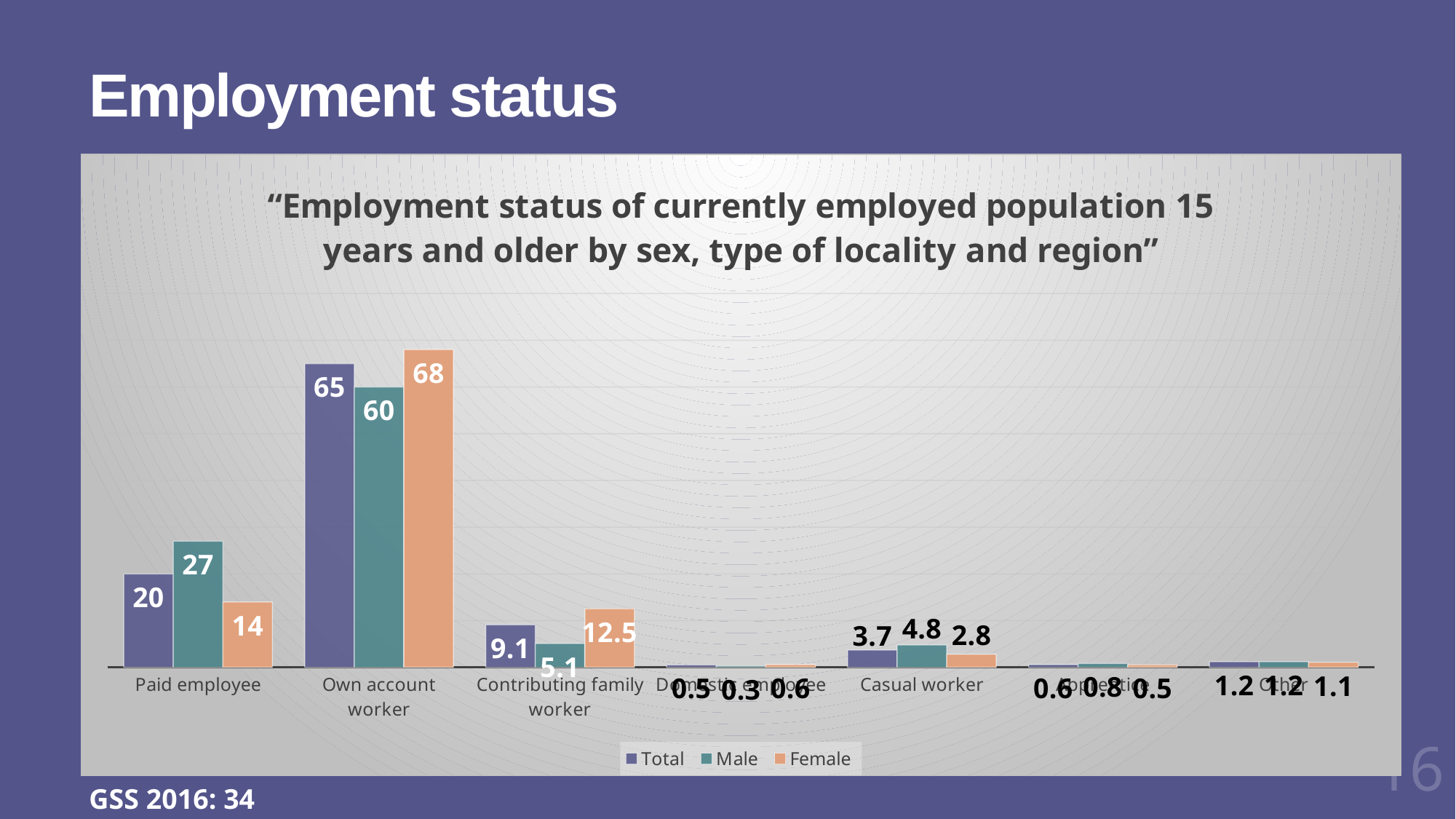
How many categories are shown on the x axis? 7 How many series does the legend list? 3 What is the Male value for Casual worker? 4.8 What is the Female value for Paid employee? 14 What is the Male value for Contributing family worker? 5.1 What kind of chart is shown on the slide? Bar chart What is the difference between the Female and Total values for Own account worker? 3 What is the difference between the Male and Female values for Paid employee? 13 Which is larger for Casual worker, the Total value or the Male value? Male What is the Total value for Own account worker? 65 Which category has the highest Female value? Own account worker Which is larger for Contributing family worker, the Male value or the Female value? Female